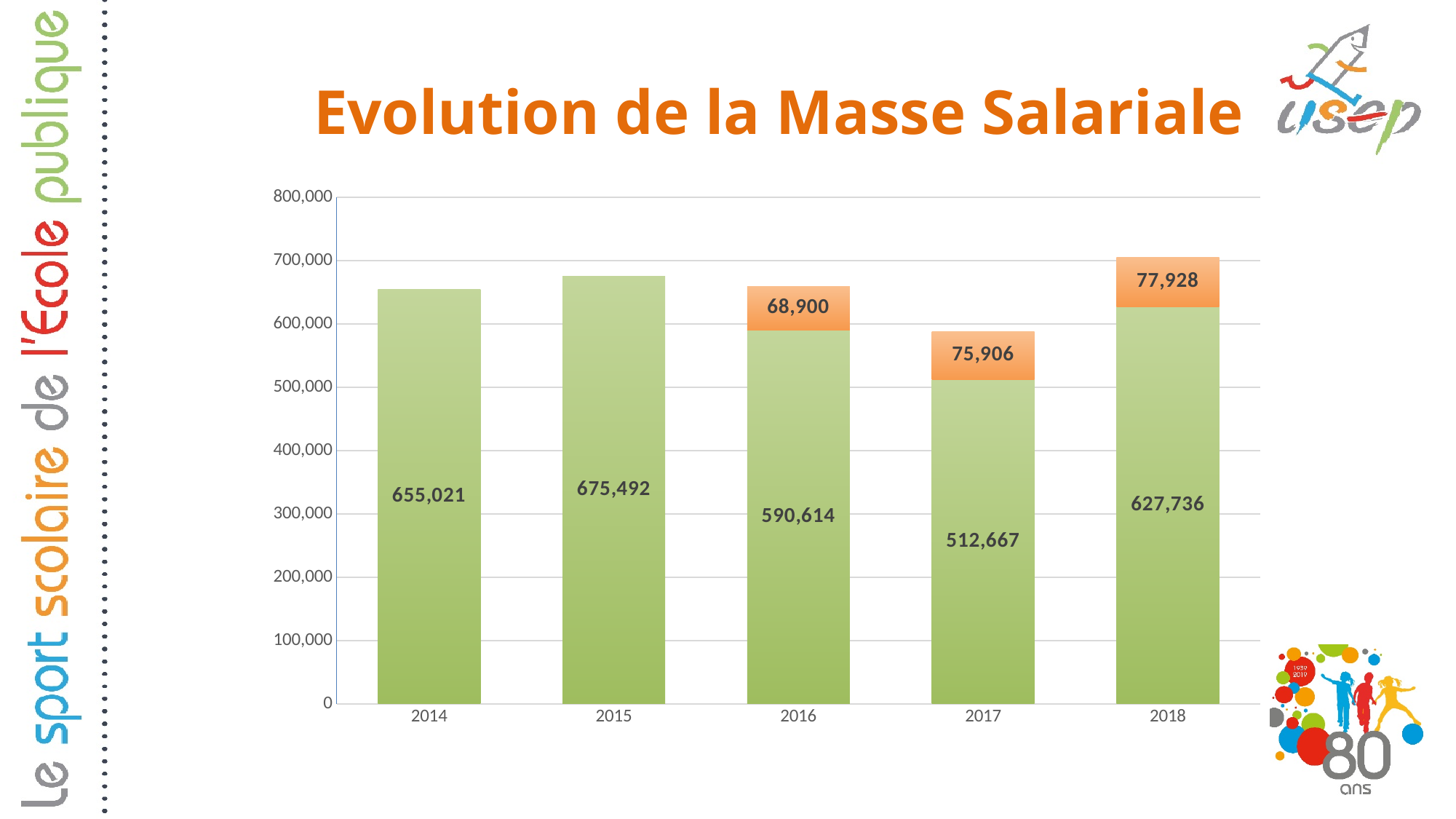
Is the total height of the 2018 bar greater or less than 700,000? greater What is the total of the stacked bar for 2016? 659,514 Which is larger, the orange segment for 2016 or the orange segment for 2018? 2018 What is the title of the chart? Evolution de la Masse Salariale What is the difference between the green segment values for 2015 and 2014? 20,471 What is the value of the green segment for 2018? 627,736 What is the value of the green segment for 2014? 655,021 Which year has the lowest green segment value? 2017 What kind of chart is shown on the slide? Stacked bar chart How many years are shown on the x axis? 5 Which year has the highest green segment value? 2015 What is the value of the orange segment for 2017? 75,906